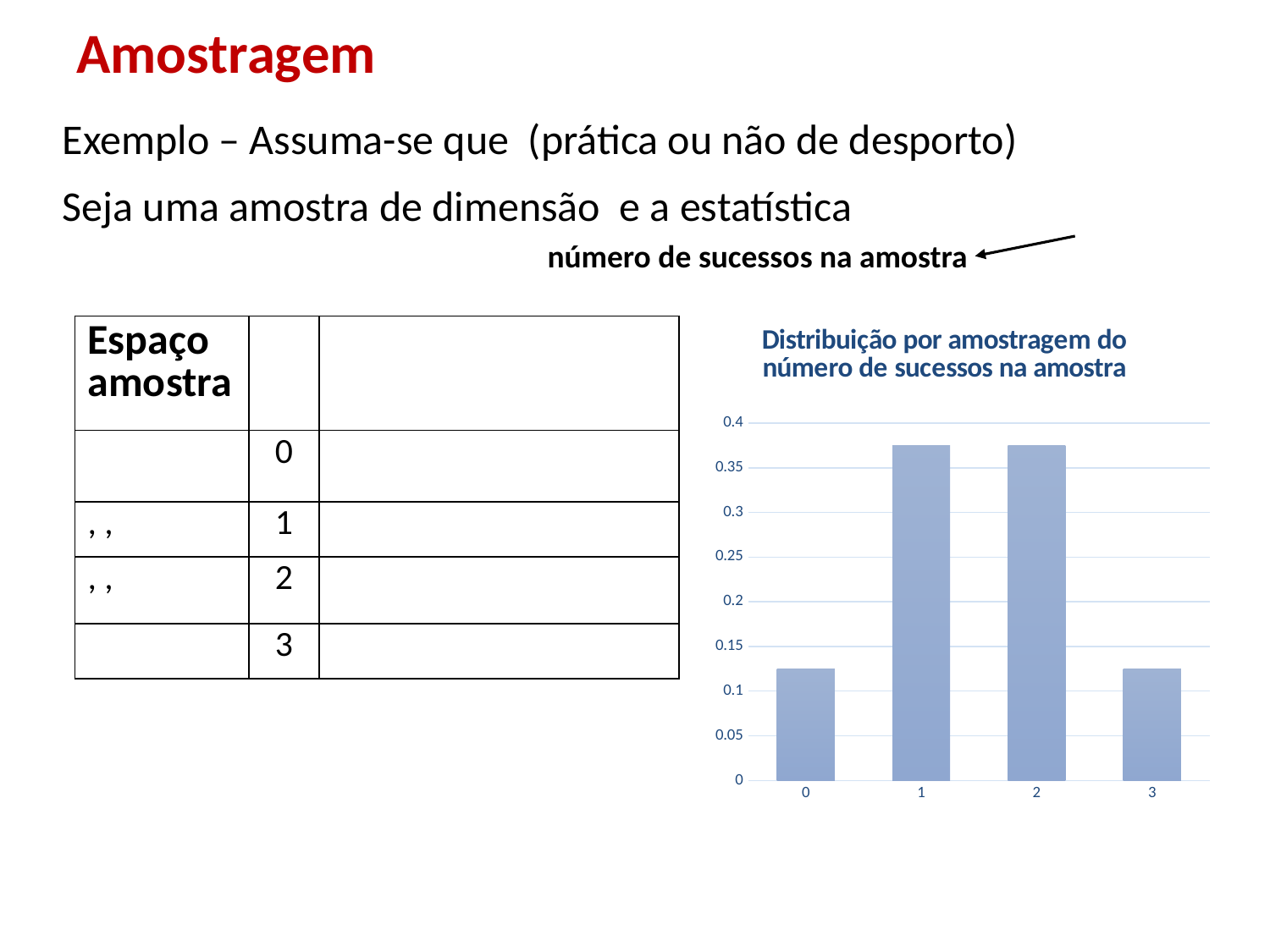
Is the value for category 0 greater or less than 0.1? greater How many categories are shown on the x axis of the chart? 4 Which is larger, the value for category 2 or the value for category 3? 2 Which is larger, the value for category 0 or the value for category 1? 1 Is the value for category 1 greater or less than 0.35? greater Do the values rise or fall from category 2 to category 3? fall What kind of chart is shown on the slide? bar chart Is the value for category 2 greater or less than 0.4? less What is the highest value shown on the y axis of the chart? 0.4 What is the title of the chart? Distribuição por amostragem do número de sucessos na amostra